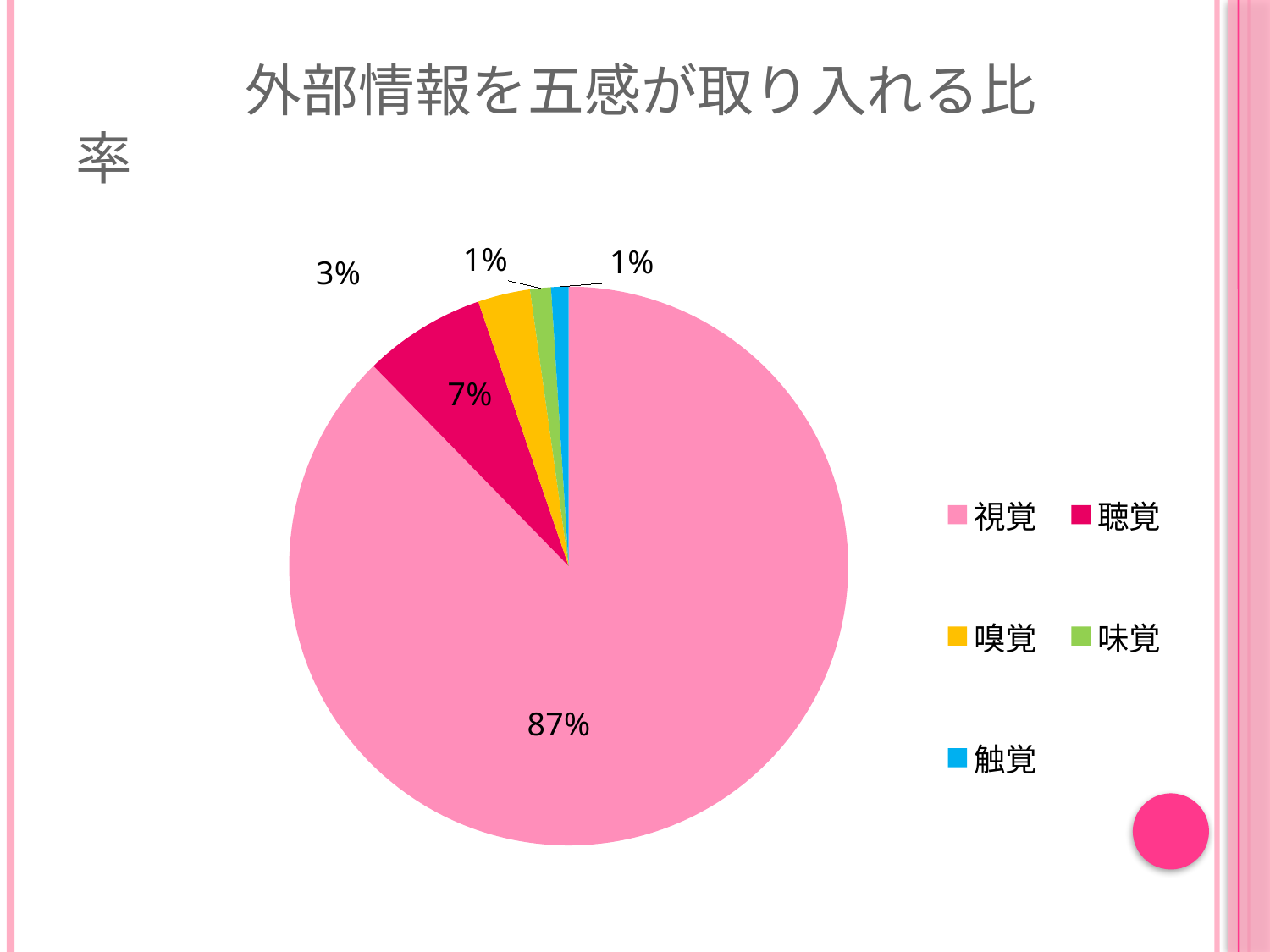
What is the difference in percentage points between 視覚 and 聴覚? 80 What percentage of the pie is 視覚? 87% Which category has the largest share of the pie? 視覚 Which is larger, the share for 聴覚 or the share for 嗅覚? 聴覚 What percentage of the pie is 聴覚? 7% What percentage of the pie is 触覚? 1% Which colour represents 嗅覚 in the chart? yellow What is the title of the chart? 外部情報を五感が取り入れる比率 What kind of chart is shown on the slide? pie chart What percentage of the pie is 嗅覚? 3% How many categories does the legend list? 5 What is the difference in percentage points between 嗅覚 and 味覚? 2